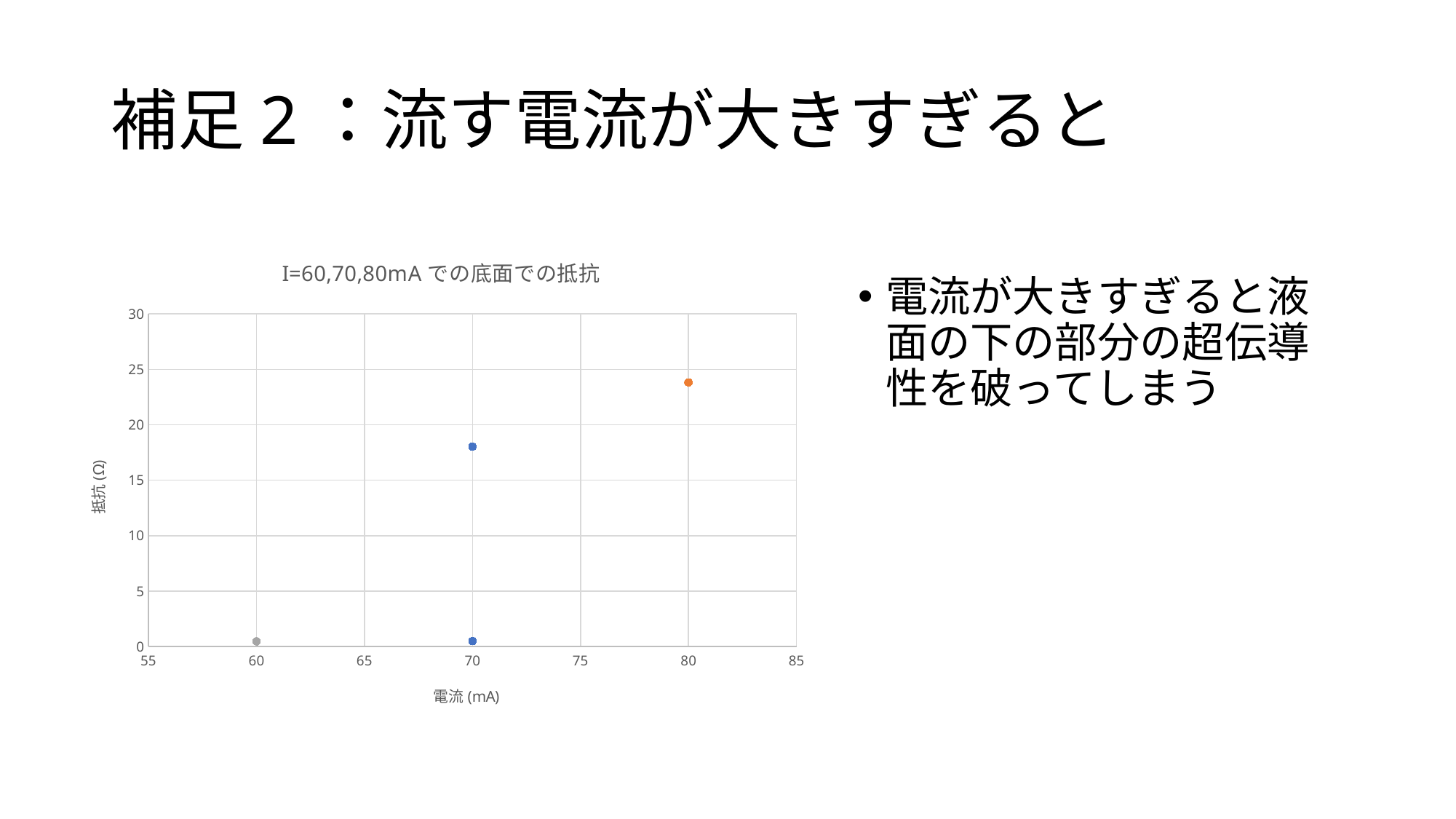
At which current (mA) is the highest resistance plotted? 80 What kind of chart is shown on the slide? scatter chart What is the highest value shown on the y axis of the chart? 30 Is the resistance value of the point at 80 mA greater or less than 20? greater How many data points are plotted on the chart? 4 What is the label of the x axis of the chart? 電流 (mA) Does the maximum plotted resistance rise or fall as the current increases from 60 mA to 80 mA? rise Is the resistance value of the higher point at 70 mA greater or less than 15? greater Is the resistance value of the higher point at 70 mA greater or less than 20? less What is the title of the chart? I=60,70,80mA での底面での抵抗 Which has the larger resistance: the point at 80 mA or the higher point at 70 mA? the point at 80 mA